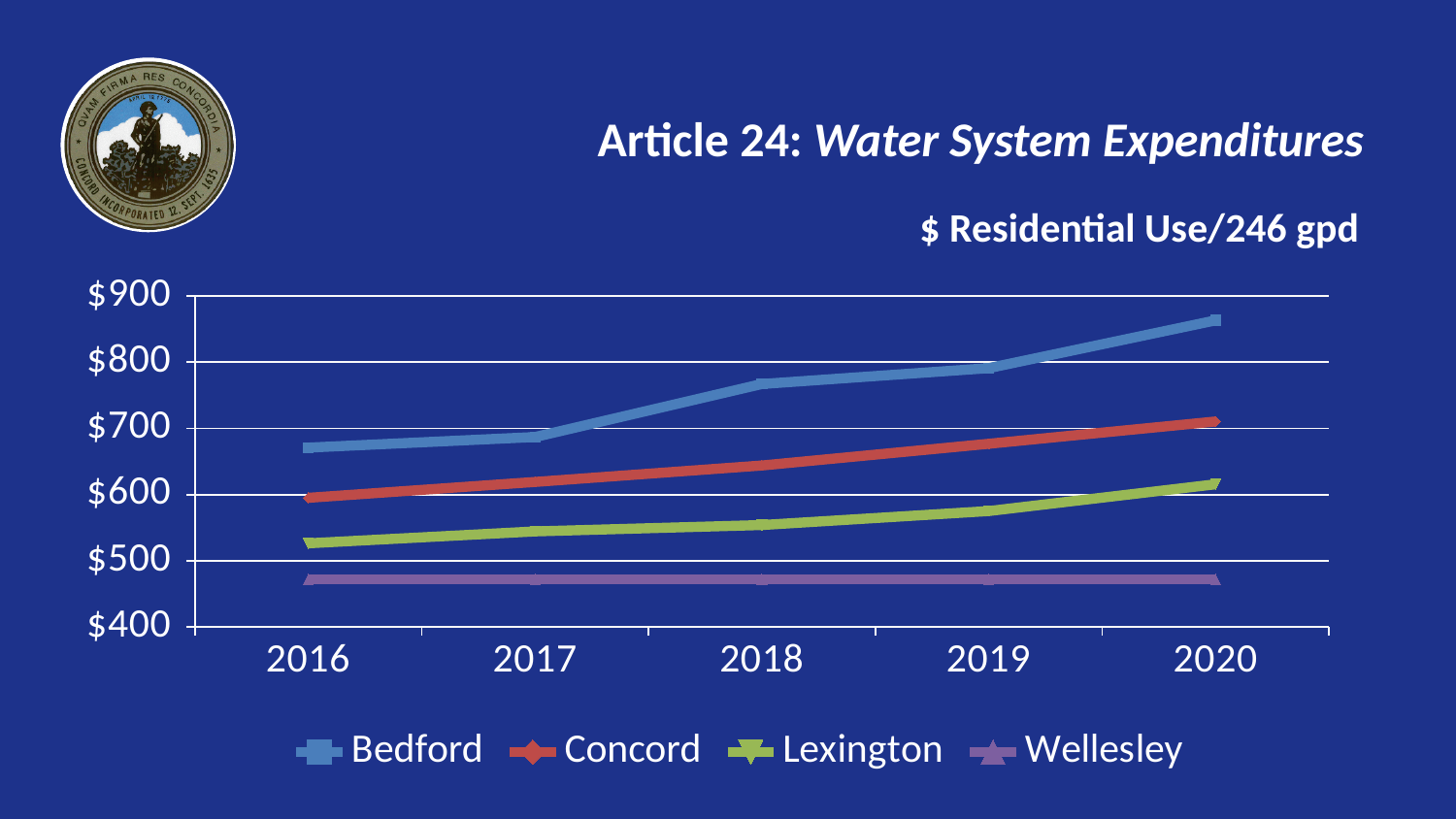
Which is larger in 2019, the value for Concord or the value for Lexington? Concord Which town has the lowest value in 2016? Wellesley Is the value for Concord in 2018 greater or less than $600? greater Which town has the highest value in 2020? Bedford How many years are shown on the x axis? 5 Is the value for Bedford in 2020 greater or less than $800? greater What kind of chart is shown on the slide? Line chart What is the title shown above the chart? $ Residential Use/246 gpd How many series does the legend list? 4 Is the value for Bedford in 2016 greater or less than $700? less Does the value for Bedford rise or fall from 2016 to 2020? Rises